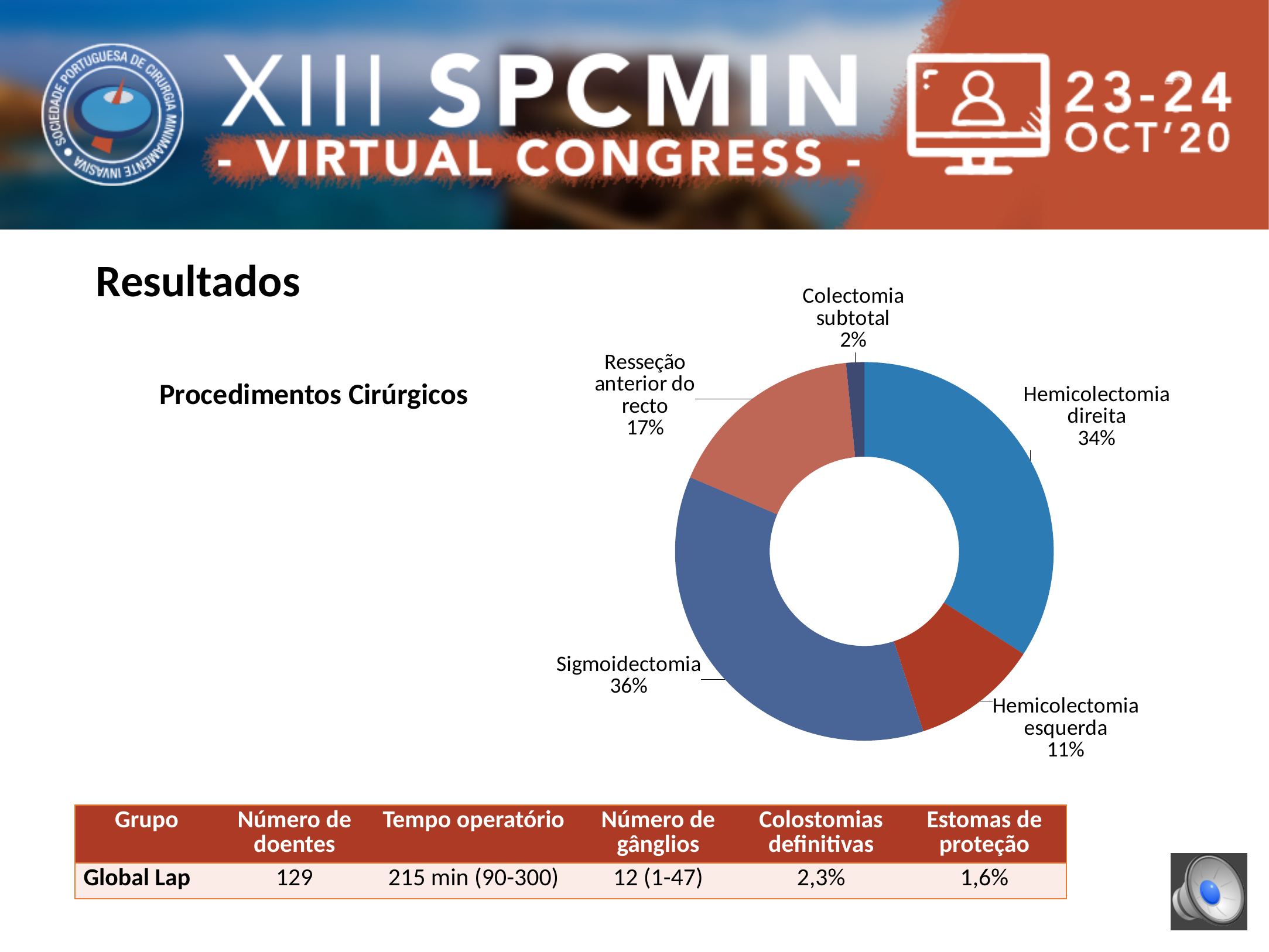
What is the value shown for Colectomia subtotal? 2% What is the title of the chart? Procedimentos Cirúrgicos What share of the pie chart does Sigmoidectomia represent? 36% How many procedure categories are shown in the pie chart? 5 What is the difference in percentage points between Resseção anterior do recto and Hemicolectomia esquerda? 6 Which is larger, the share for Hemicolectomia direita or the share for Resseção anterior do recto? Hemicolectomia direita What is the value shown for Hemicolectomia esquerda? 11% What is the value shown for Resseção anterior do recto? 17% Which procedure has the smallest share of the pie chart? Colectomia subtotal Which procedure has the largest share of the pie chart? Sigmoidectomia What kind of chart is shown on the slide? Pie chart (doughnut) What share of the pie chart does Hemicolectomia direita represent? 34%